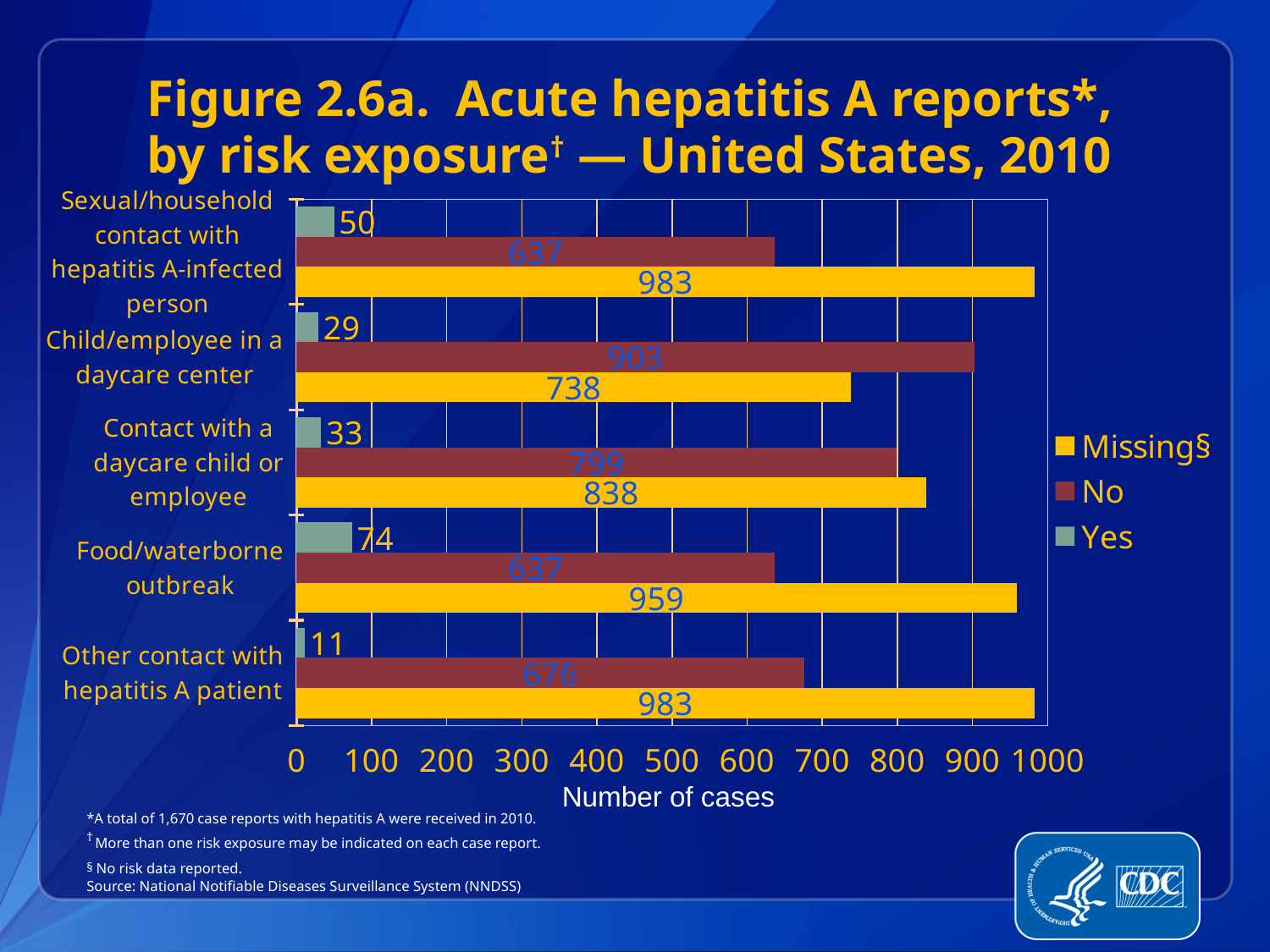
Which has a larger 'Missing' value: Child/employee in a daycare center or Contact with a daycare child or employee? Contact with a daycare child or employee What is the number of cases for the 'Yes' series in the Food/waterborne outbreak category? 74 Which risk exposure category has the highest value for the 'No' series? Child/employee in a daycare center Which risk exposure category has the lowest value for the 'Yes' series? Other contact with hepatitis A patient What is the number of cases for the 'No' series in the Child/employee in a daycare center category? 903 What is the difference between the 'Yes' values for Food/waterborne outbreak and Sexual/household contact with hepatitis A-infected person? 24 How many risk exposure categories are shown on the chart? 5 Which risk exposure category has the highest value for the 'Yes' series? Food/waterborne outbreak What is the number of cases for the 'Yes' series in the Child/employee in a daycare center category? 29 What is the number of cases for the 'Missing' series in the Contact with a daycare child or employee category? 838 Is the 'No' value for Child/employee in a daycare center greater or less than 800? greater How many series does the legend list? 3